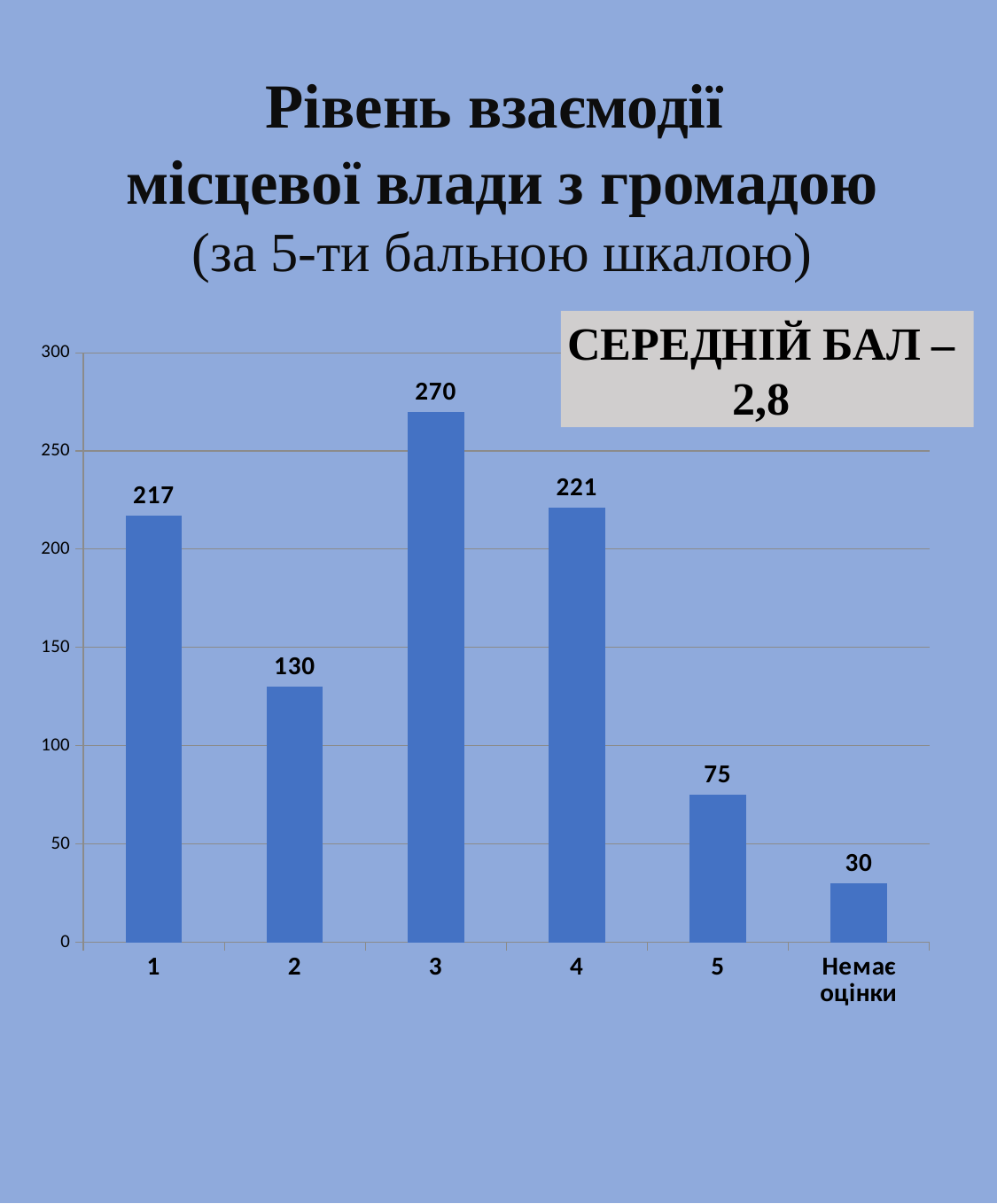
What is the value for the 'Немає оцінки' category? 30 What is the value for category 5? 75 Is the value for category 2 greater or less than 150? less Which category has the lowest value? Немає оцінки How many categories are shown on the x axis? 6 Which is larger, the value for category 1 or the value for category 2? 1 Which category has the highest value? 3 What average score (середній бал) is stated on the slide? 2,8 What is the difference between the values for category 3 and category 2? 140 What is the value for category 3? 270 What is the difference between the values for category 4 and category 1? 4 What kind of chart is shown on the slide? bar chart